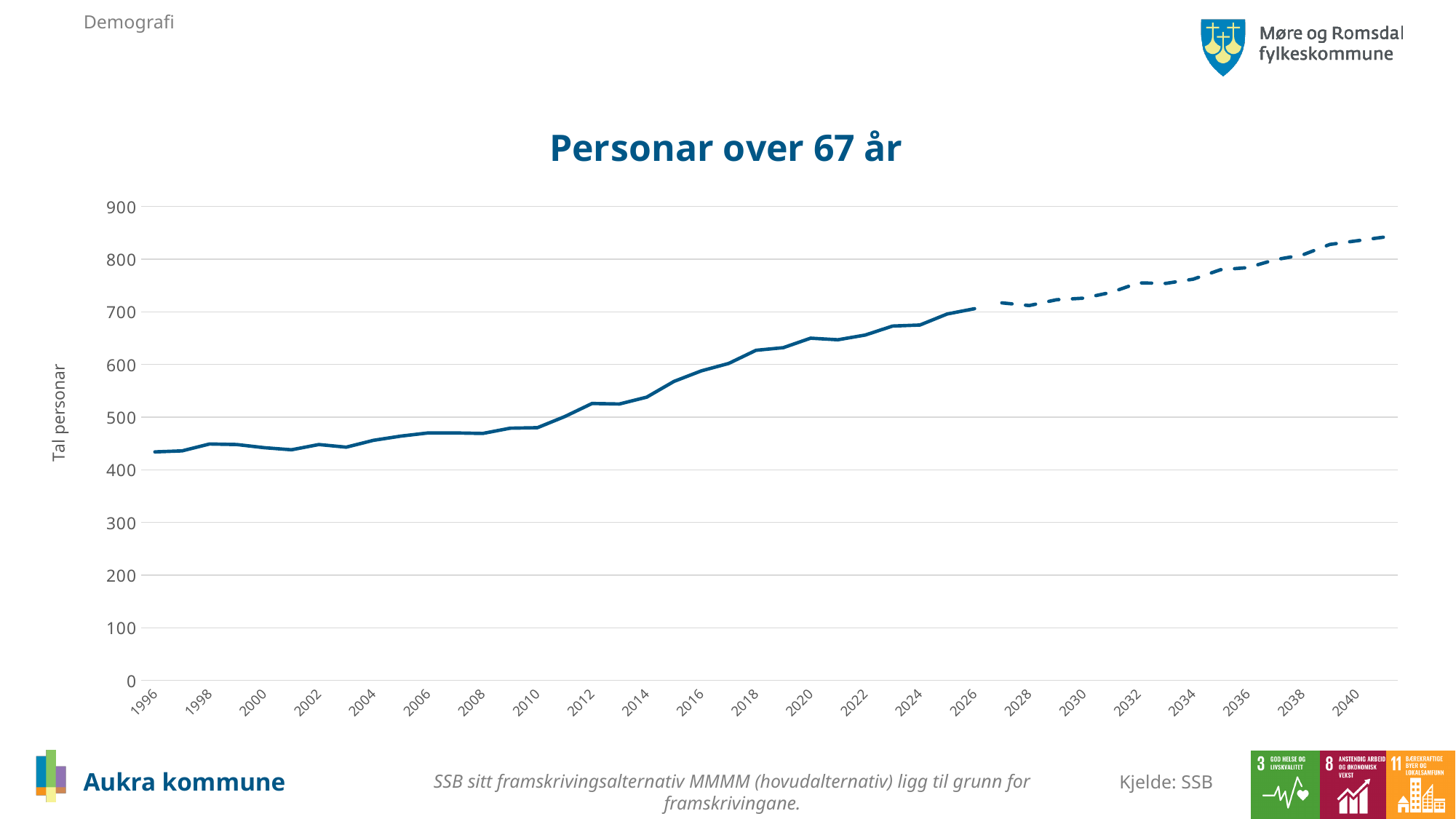
Do the values in the chart generally rise or fall from 1996 to 2040? rise Which is larger, the value for 2000 or the value for 2020? 2020 Which is larger, the value for 2010 or the value for 2030? 2030 Is the value for 2016 greater or less than 500? greater Is the value for 2040 greater or less than 800? greater What is the label on the vertical axis of the chart? Tal personar Is the value for 1996 greater or less than 500? less What is the title of the chart? Personar over 67 år What kind of chart is shown on the slide? line chart Which year has the highest value in the chart? 2041